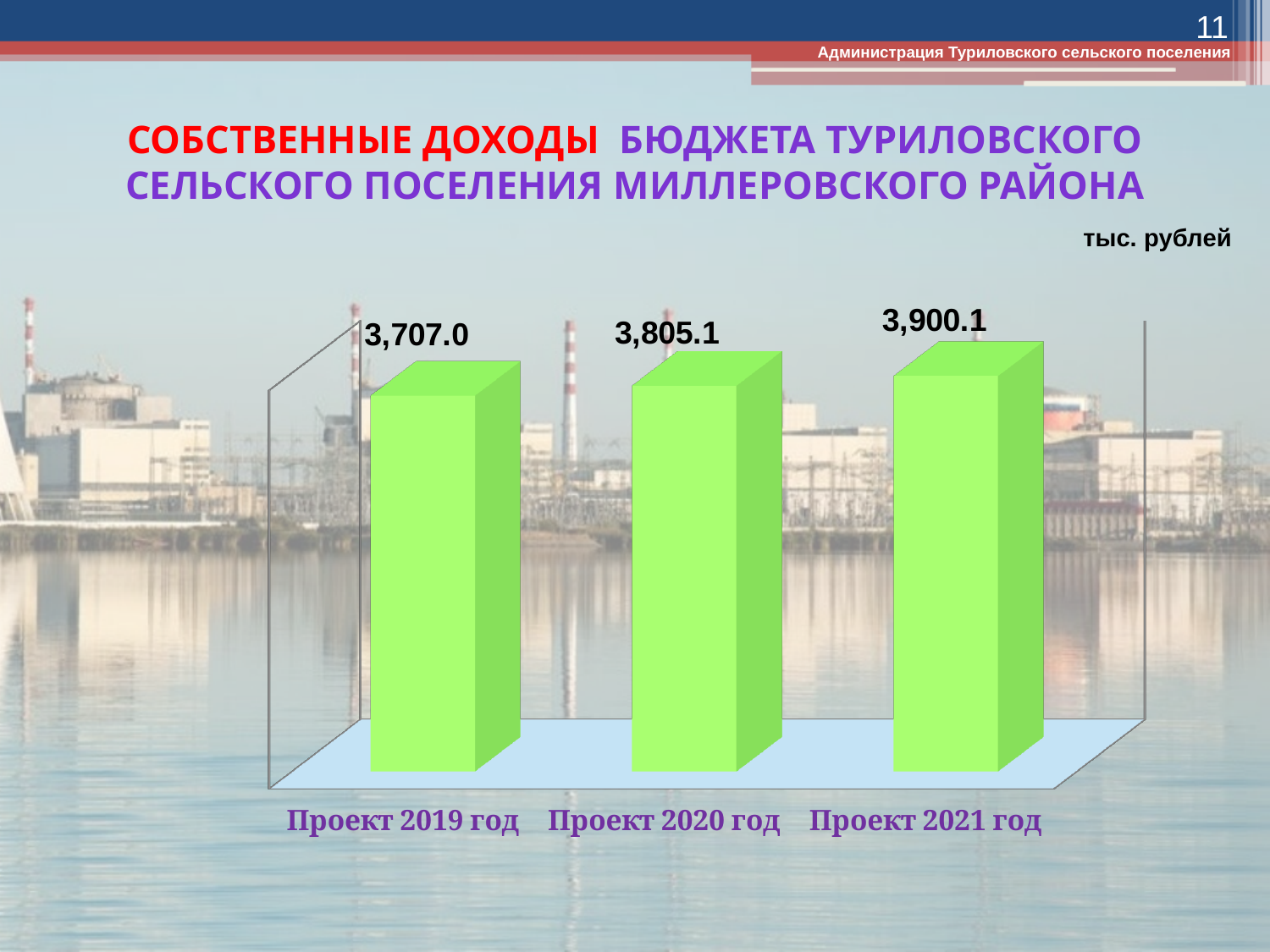
How many categories are shown in the chart? 3 What is the difference between the values for Проект 2020 год and Проект 2019 год? 98.1 What is the value for Проект 2020 год? 3,805.1 What is the value for Проект 2021 год? 3,900.1 In what units are the chart values given? тыс. рублей Which category has the highest value? Проект 2021 год Which category has the lowest value? Проект 2019 год What is the value for Проект 2019 год? 3,707.0 Do the values rise or fall from Проект 2019 год to Проект 2021 год? Rise What is the difference between the values for Проект 2021 год and Проект 2019 год? 193.1 Which is larger, the value for Проект 2020 год or Проект 2021 год? Проект 2021 год What kind of chart is shown on the slide? Bar chart